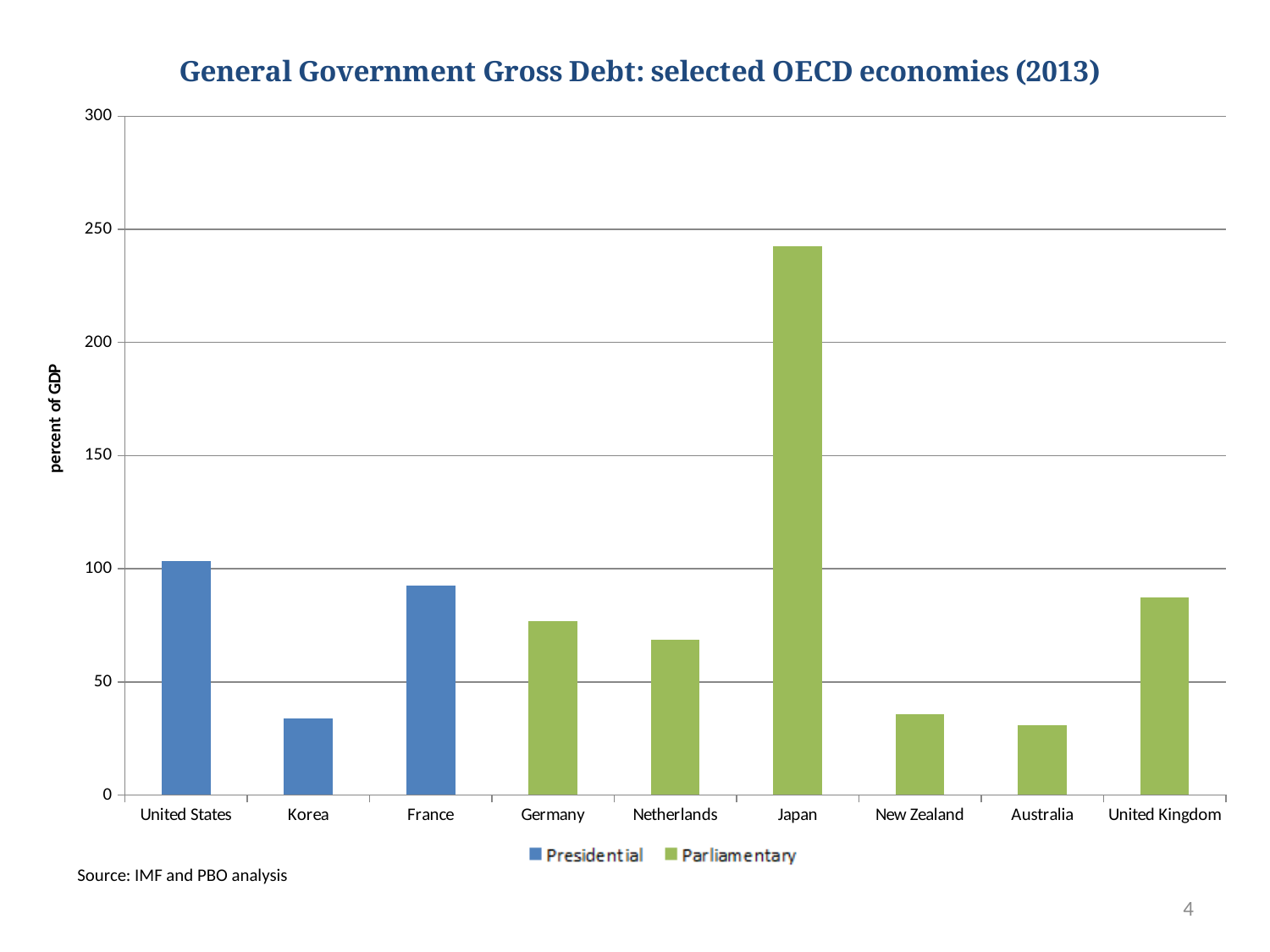
What kind of chart is shown on the slide? Bar chart Is the value for the United Kingdom greater or less than 100? less Which has a higher value, the United States or France? United States How many countries are shown on the x axis? 9 Which country has the highest general government gross debt as a percent of GDP? Japan Is the value for Korea greater or less than 50? less Which has a higher value, Germany or the Netherlands? Germany Is the value for France greater or less than 100? less How many series does the legend list? 2 Which legend series is Japan's bar coloured as? Parliamentary